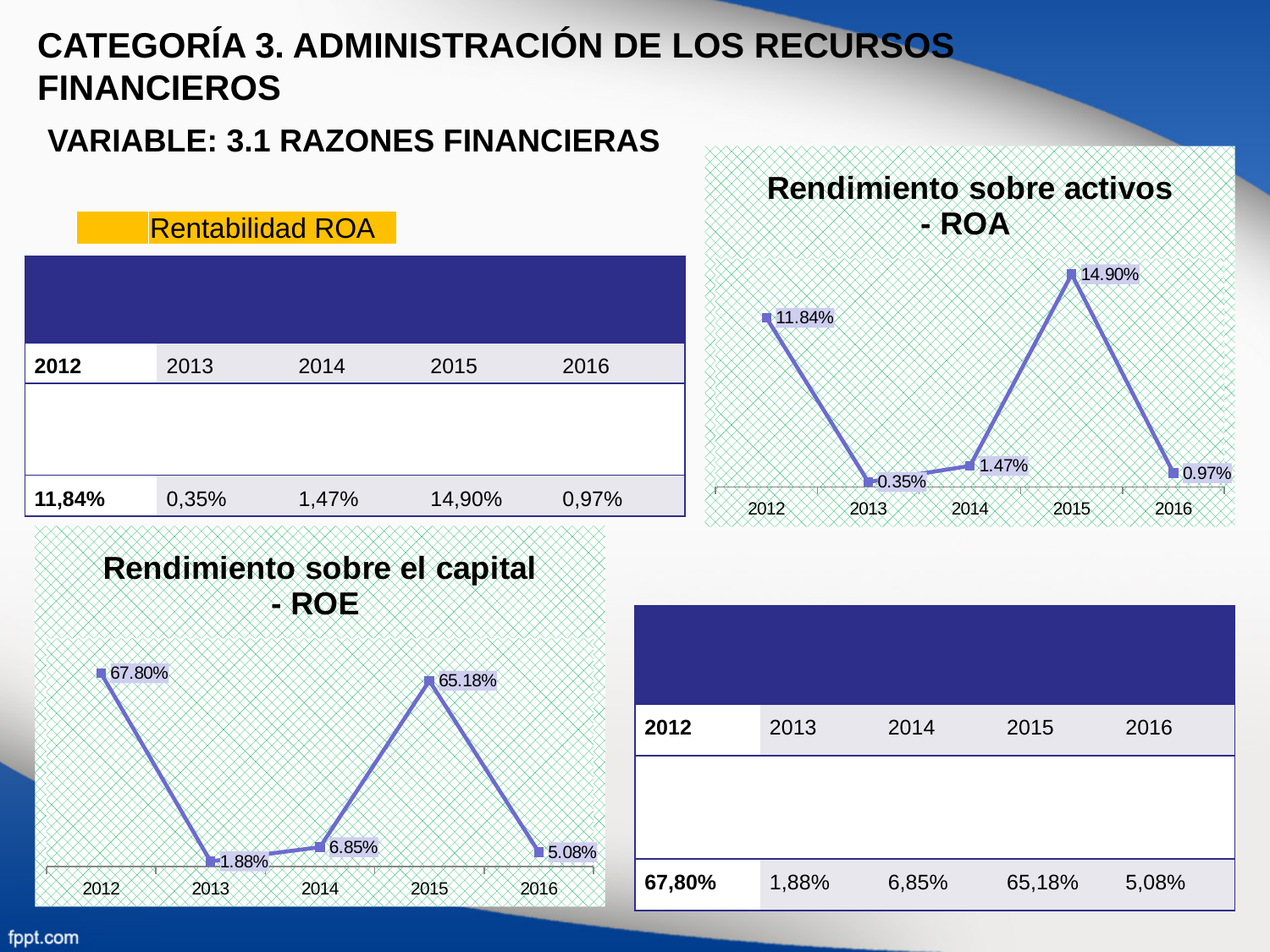
In the 'Rendimiento sobre activos - ROA' chart, what is the value for 2013? 0.35% What kind of chart is 'Rendimiento sobre activos - ROA'? Line chart In the 'Rendimiento sobre el capital - ROE' chart, what is the value for 2012? 67.80% How many data points are plotted in the 'Rendimiento sobre el capital - ROE' chart? 5 In the 'Rendimiento sobre el capital - ROE' chart, which year has the lowest value? 2013 In the 'Rendimiento sobre el capital - ROE' chart, which is larger, the value for 2014 or the value for 2016? 2014 In the 'Rendimiento sobre activos - ROA' chart, which year has the highest value? 2015 In the 'Rendimiento sobre activos - ROA' chart, what is the value for 2015? 14.90% In the 'Rendimiento sobre activos - ROA' chart, which year has the lowest value? 2013 In the 'Rendimiento sobre el capital - ROE' chart, what is the difference between the 2012 and 2015 values? 2.62% In the 'Rendimiento sobre activos - ROA' chart, what is the difference between the 2015 and 2012 values? 3.06% In the 'Rendimiento sobre el capital - ROE' chart, what is the value for 2016? 5.08%